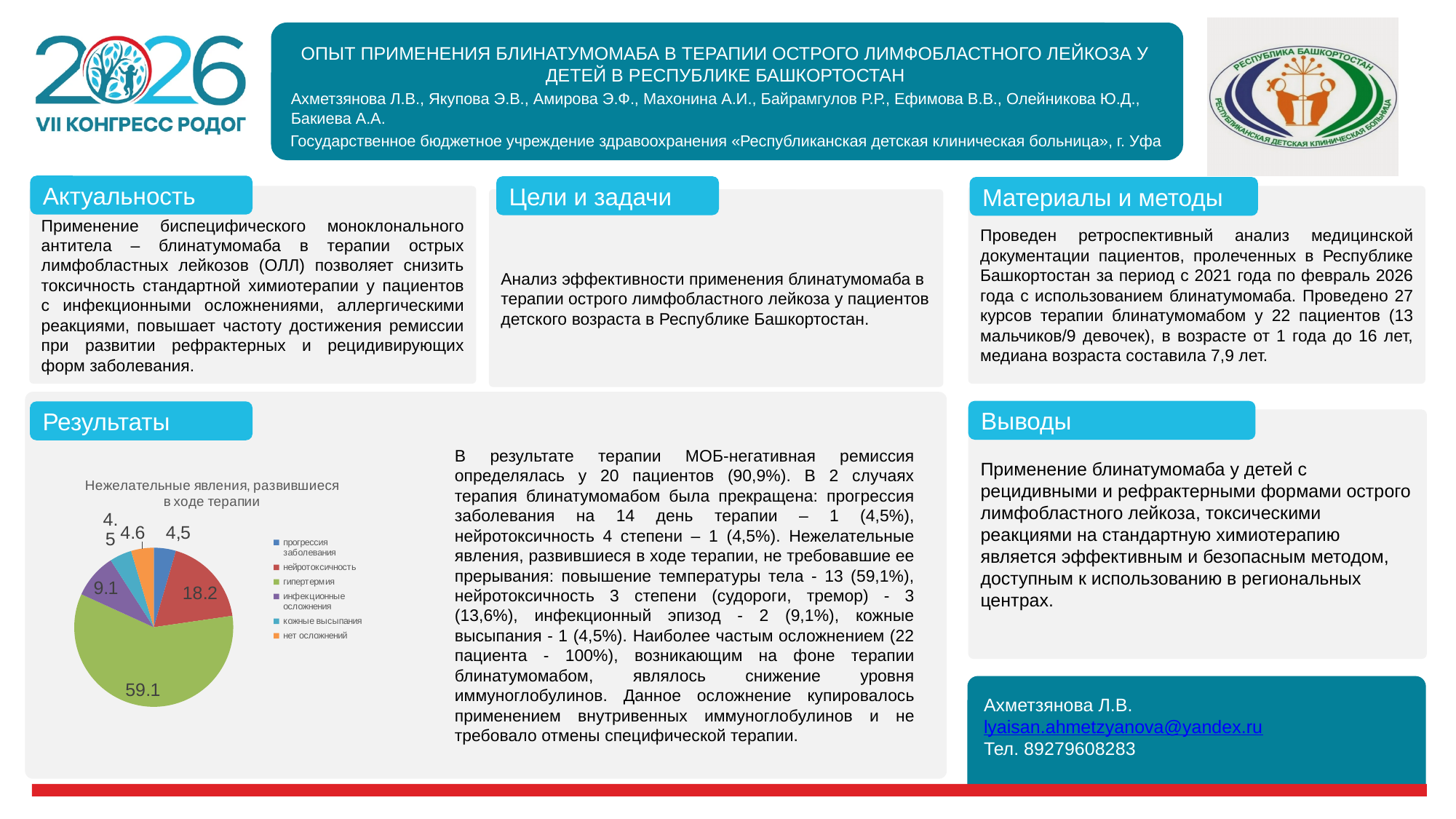
What value is shown for инфекционные осложнения in the pie chart? 9.1 What value is shown for гипертермия in the pie chart? 59.1 What kind of chart is shown in the Результаты section? pie chart Which category has the largest slice in the pie chart? гипертермия What is the difference between the values for гипертермия and нейротоксичность in the pie chart? 40.9 What value is shown for нет осложнений in the pie chart? 4.6 What is the title of the pie chart? Нежелательные явления, развившиеся в ходе терапии What colour is the slice for гипертермия in the pie chart? green What value is shown for нейротоксичность in the pie chart? 18.2 How many slices does the pie chart have? 6 Which is larger in the pie chart: нейротоксичность or инфекционные осложнения? нейротоксичность How many entries does the legend of the pie chart list? 6